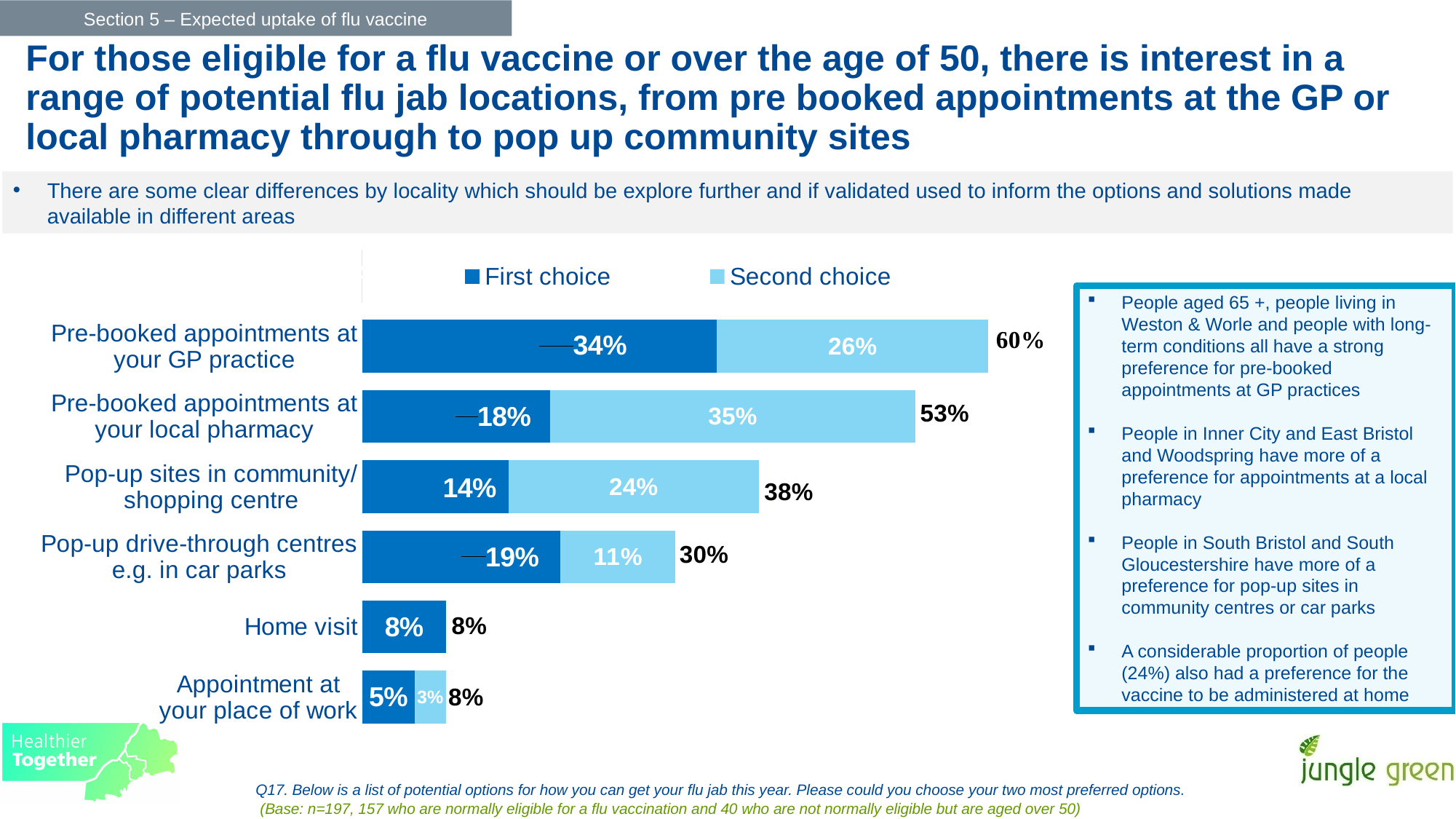
What is the Second choice value for Pre-booked appointments at your local pharmacy? 35% How many categories are shown in the chart? 6 Which category has the highest First choice value? Pre-booked appointments at your GP practice What is the Second choice value for Pop-up drive-through centres e.g. in car parks? 11% What kind of chart is shown on the slide? Stacked bar chart What is the total shown for the Pop-up sites in community/ shopping centre bar? 38% How many series does the legend list? 2 What are the two series named in the chart legend? First choice and Second choice What is the difference between the First choice values for Pre-booked appointments at your GP practice and Pre-booked appointments at your local pharmacy? 16% What is the First choice value for Pre-booked appointments at your GP practice? 34% Which is larger: the First choice value for Pop-up drive-through centres e.g. in car parks or the First choice value for Pop-up sites in community/ shopping centre? Pop-up drive-through centres e.g. in car parks